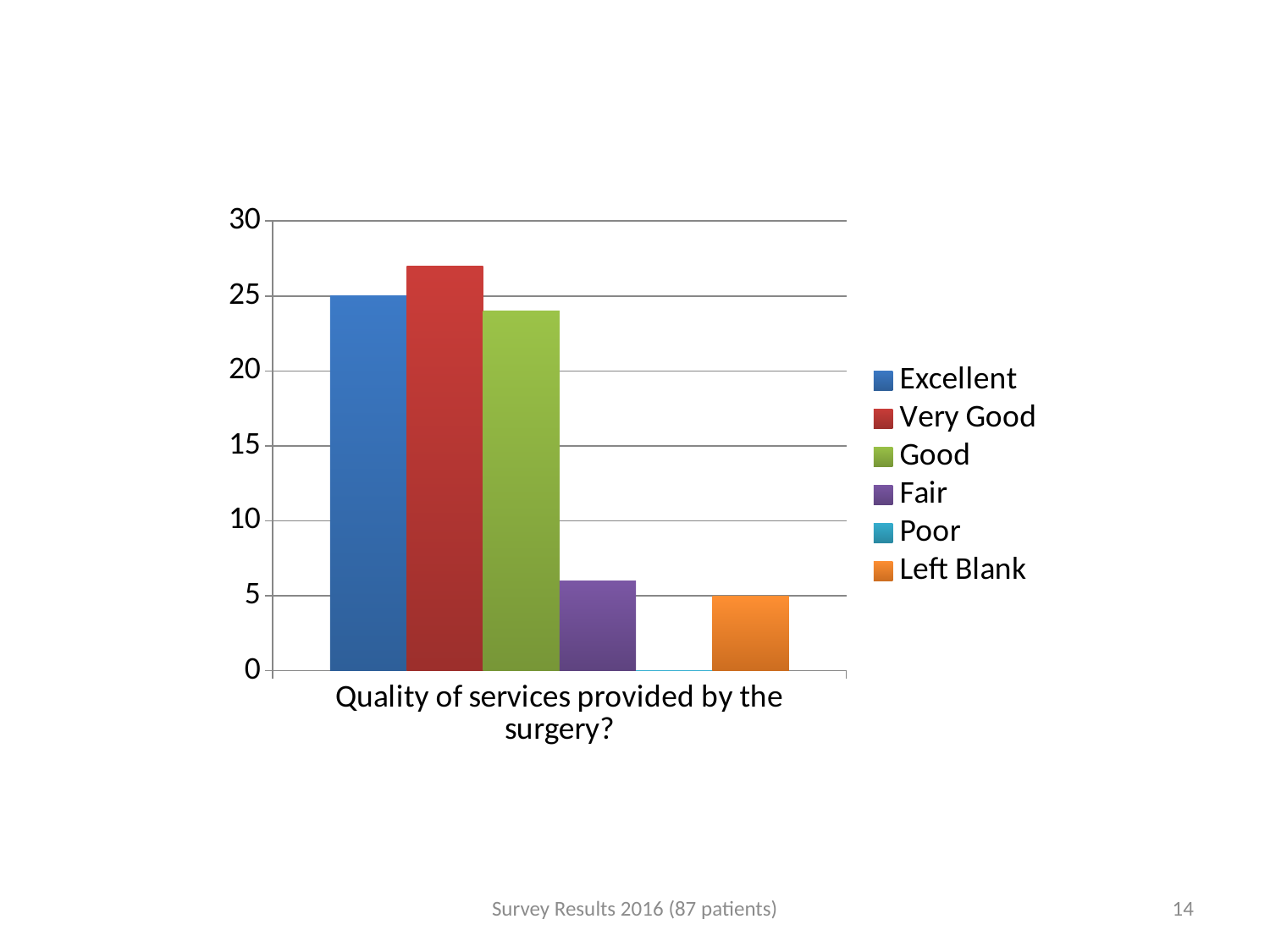
How many series does the legend list? 6 Which rating has the highest bar? Very Good Is the value for Good greater or less than 25? less What is the category label shown on the x axis? Quality of services provided by the surgery? What is the value for Excellent? 25 Is the value for Fair greater or less than 10? less Which is larger, the value for Very Good or the value for Excellent? Very Good What colour is the bar for Left Blank? orange Is the value for Very Good greater or less than 25? greater Which rating has the lowest bar? Poor What is the value for Left Blank? 5 What kind of chart is shown on the slide? bar chart